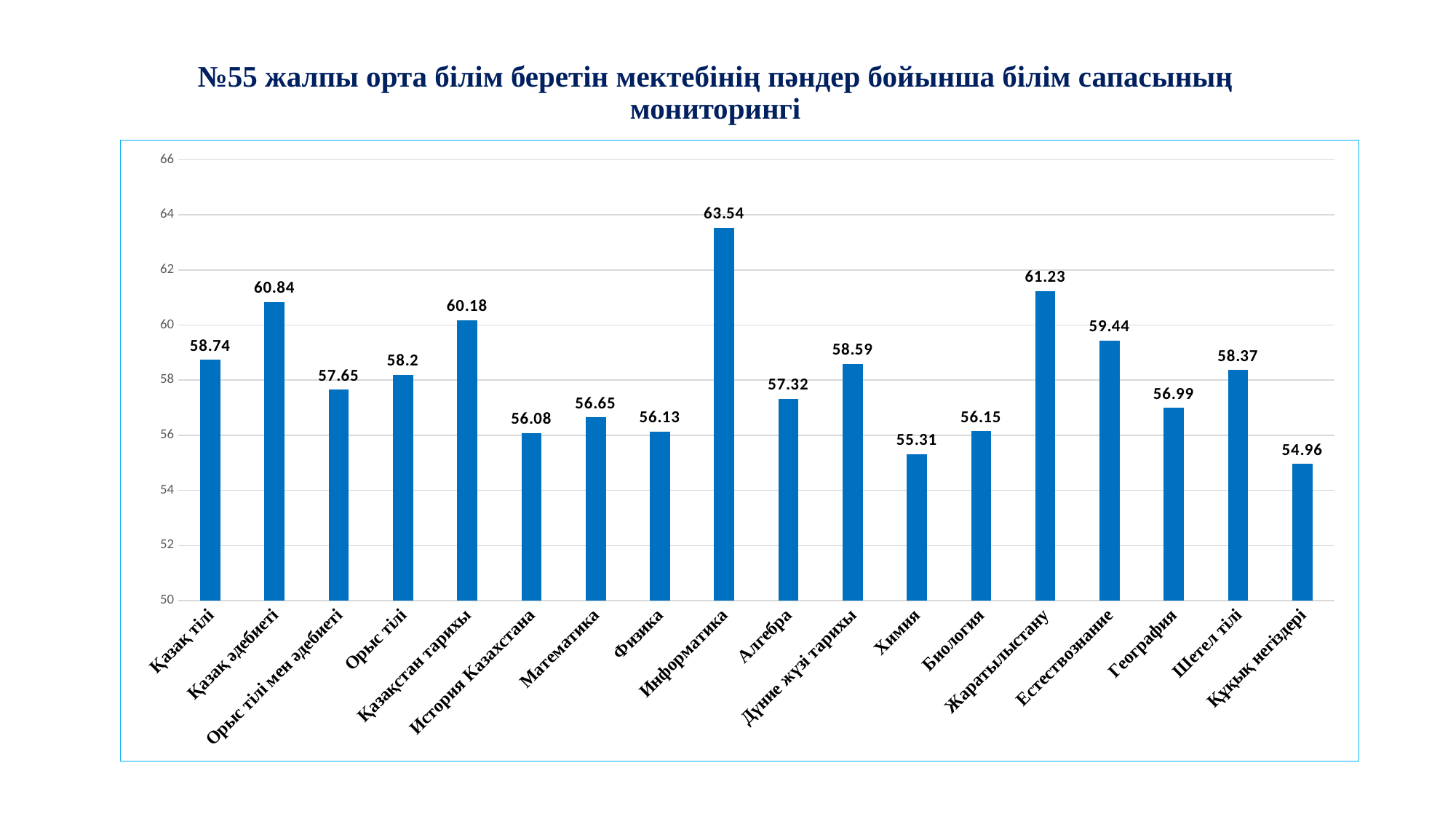
What is the value for Информатика? 63.54 What is the value for Химия? 55.31 What kind of chart is shown on the slide? bar chart What is the value for Естествознание? 59.44 Which is larger, the value for Естествознание or the value for Дүние жүзі тарихы? Естествознание How many subjects are shown on the chart? 18 What is the difference between the values for Информатика and Жаратылыстану? 2.31 Which subject has the highest value? Информатика Which subject has the lowest value? Құқық негіздері What is the difference between the values for Қазақ әдебиеті and Қазақ тілі? 2.1 Is the value for Химия greater or less than 56? less What is the value for Қазақ әдебиеті? 60.84